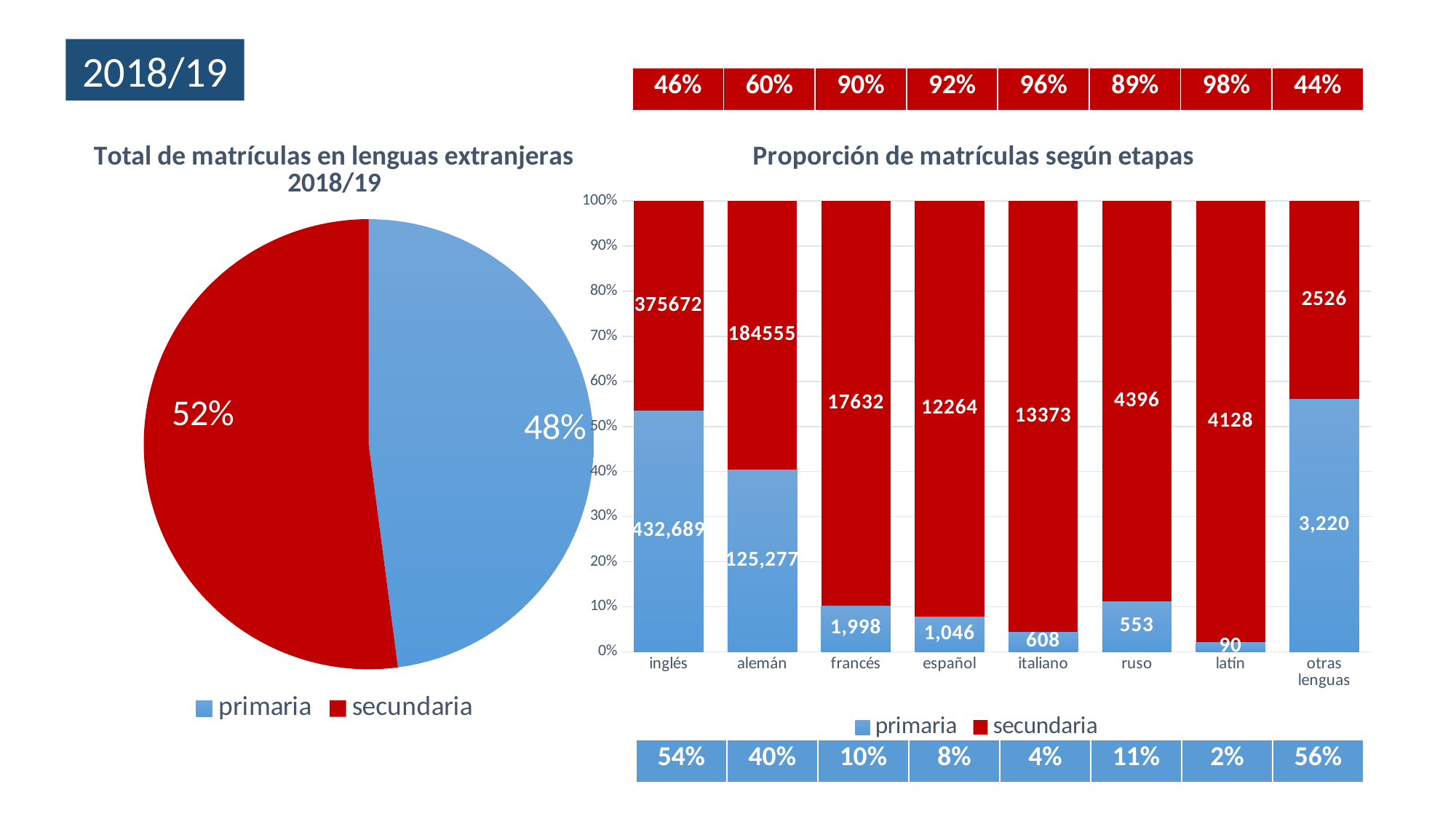
In the chart 'Proporción de matrículas según etapas', which language has the lowest primaria value? latín In the chart 'Proporción de matrículas según etapas', is the primaria share for ruso greater or less than 10%? greater In the chart 'Proporción de matrículas según etapas', what is the secundaria value for otras lenguas? 2526 In the chart 'Proporción de matrículas según etapas', what is the primaria value for inglés? 432,689 In the chart 'Proporción de matrículas según etapas', what is the secundaria value for alemán? 184555 In the chart 'Proporción de matrículas según etapas', how many series does the legend list? 2 In the chart 'Proporción de matrículas según etapas', what is the primaria value for latín? 90 In the pie chart 'Total de matrículas en lenguas extranjeras 2018/19', what share does primaria have? 48% In the chart 'Proporción de matrículas según etapas', how many language categories are shown on the x axis? 8 In the pie chart 'Total de matrículas en lenguas extranjeras 2018/19', what share does secundaria have? 52% In the pie chart 'Total de matrículas en lenguas extranjeras 2018/19', which slice is larger, primaria or secundaria? secundaria What kind of chart is 'Proporción de matrículas según etapas'? stacked bar chart